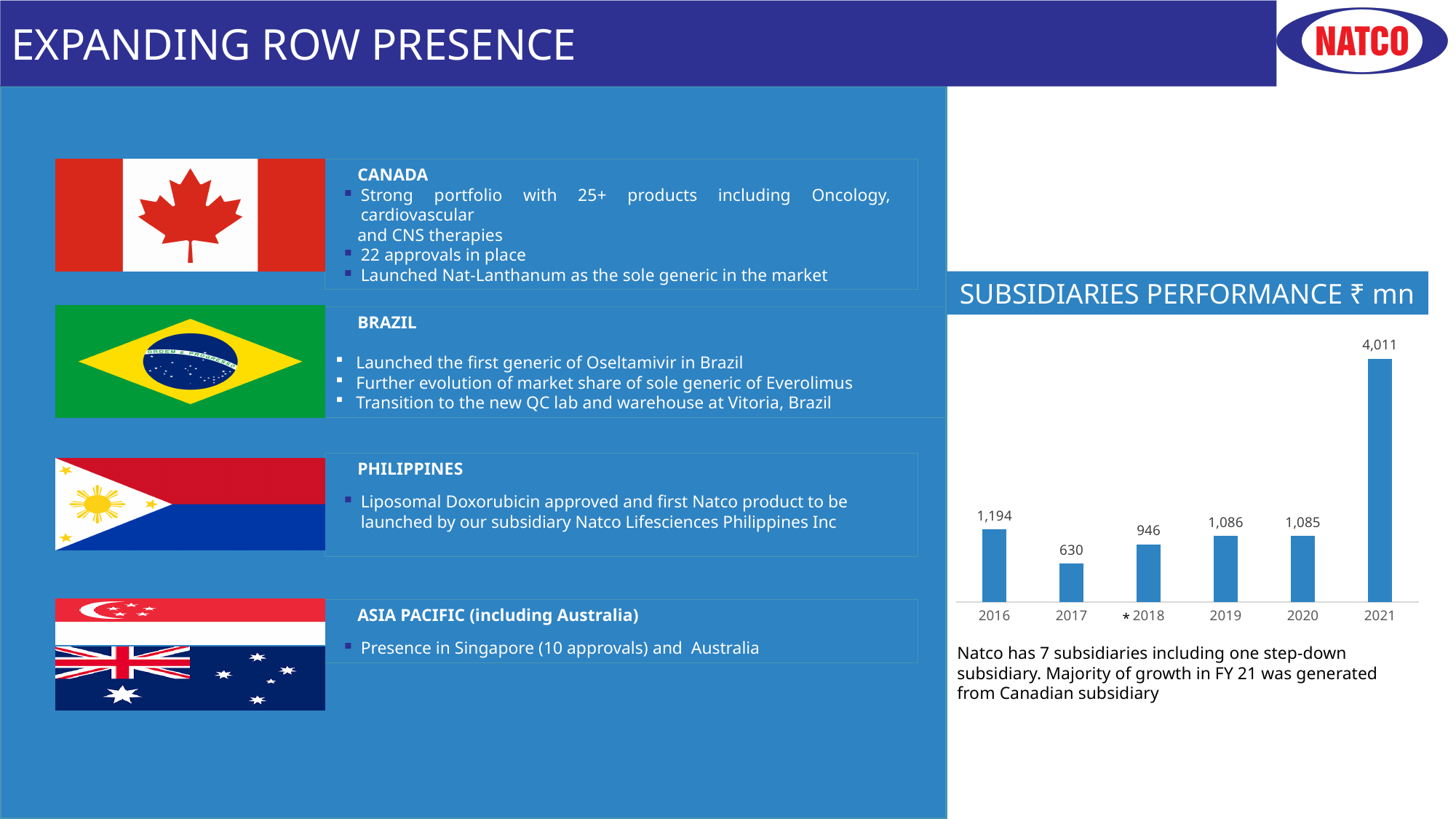
In the Subsidiaries Performance chart, which is larger, the value for 2016 or the value for 2019? 2016 How many years are shown in the Subsidiaries Performance chart? 6 What is the value for 2016 in the Subsidiaries Performance chart? 1,194 What unit is stated in the title of the Subsidiaries Performance chart? ₹ mn Which year has the highest value in the Subsidiaries Performance chart? 2021 What is the value for 2017 in the Subsidiaries Performance chart? 630 What is the value for 2021 in the Subsidiaries Performance chart? 4,011 What is the difference between the 2021 and 2020 values in the Subsidiaries Performance chart? 2,926 Which year has the lowest value in the Subsidiaries Performance chart? 2017 What is the difference between the 2016 and 2017 values in the Subsidiaries Performance chart? 564 What is the value for 2018 in the Subsidiaries Performance chart? 946 What kind of chart is the Subsidiaries Performance chart? Bar chart